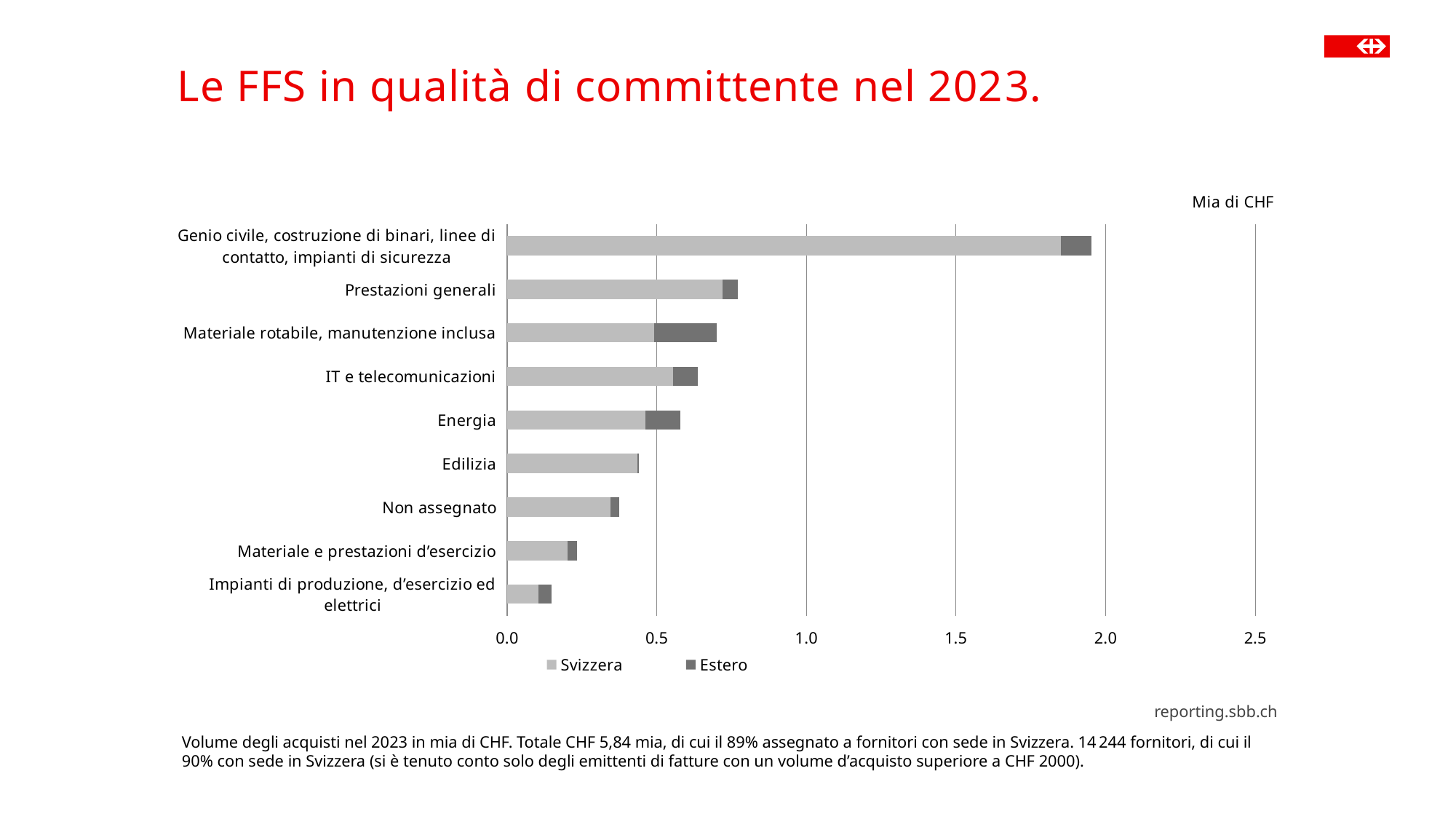
Is the total value for Prestazioni generali greater or less than 0.5? greater Which has a larger total value, Prestazioni generali or Energia? Prestazioni generali Is the total value for Genio civile, costruzione di binari, linee di contatto, impianti di sicurezza greater or less than 1.5? greater How many series does the legend list? 2 What unit is indicated for the values in the chart? Mia di CHF What are the two series named in the legend? Svizzera and Estero Which category has the lowest total value? Impianti di produzione, d'esercizio ed elettrici Which category has the highest total value? Genio civile, costruzione di binari, linee di contatto, impianti di sicurezza What kind of chart is shown on the slide? bar chart Is the total value for Edilizia greater or less than 0.5? less How many categories are plotted in the chart? 9